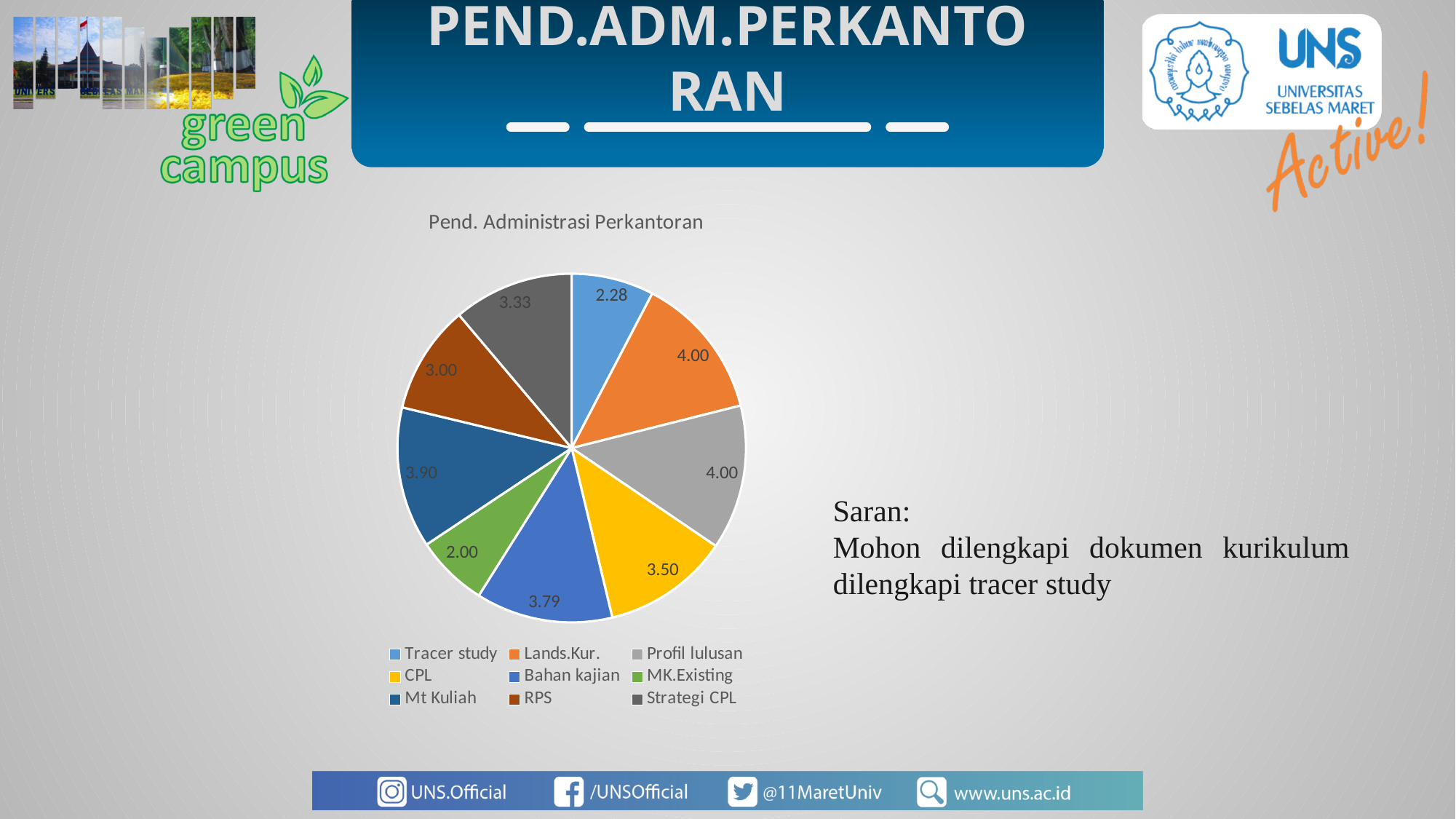
What is the value for RPS? 3.00 Which is larger, the value for Mt Kuliah or the value for RPS? Mt Kuliah What colour is the slice for CPL? yellow What is the value for Strategi CPL? 3.33 What is the value for Tracer study? 2.28 Which category has the lowest value? MK.Existing What is the value for Bahan kajian? 3.79 How many categories does the pie chart have? 9 What is the difference between the values for Lands.Kur. and CPL? 0.50 What type of chart is shown on the slide? pie chart What is the title of the chart? Pend. Administrasi Perkantoran What is the value for Mt Kuliah? 3.90